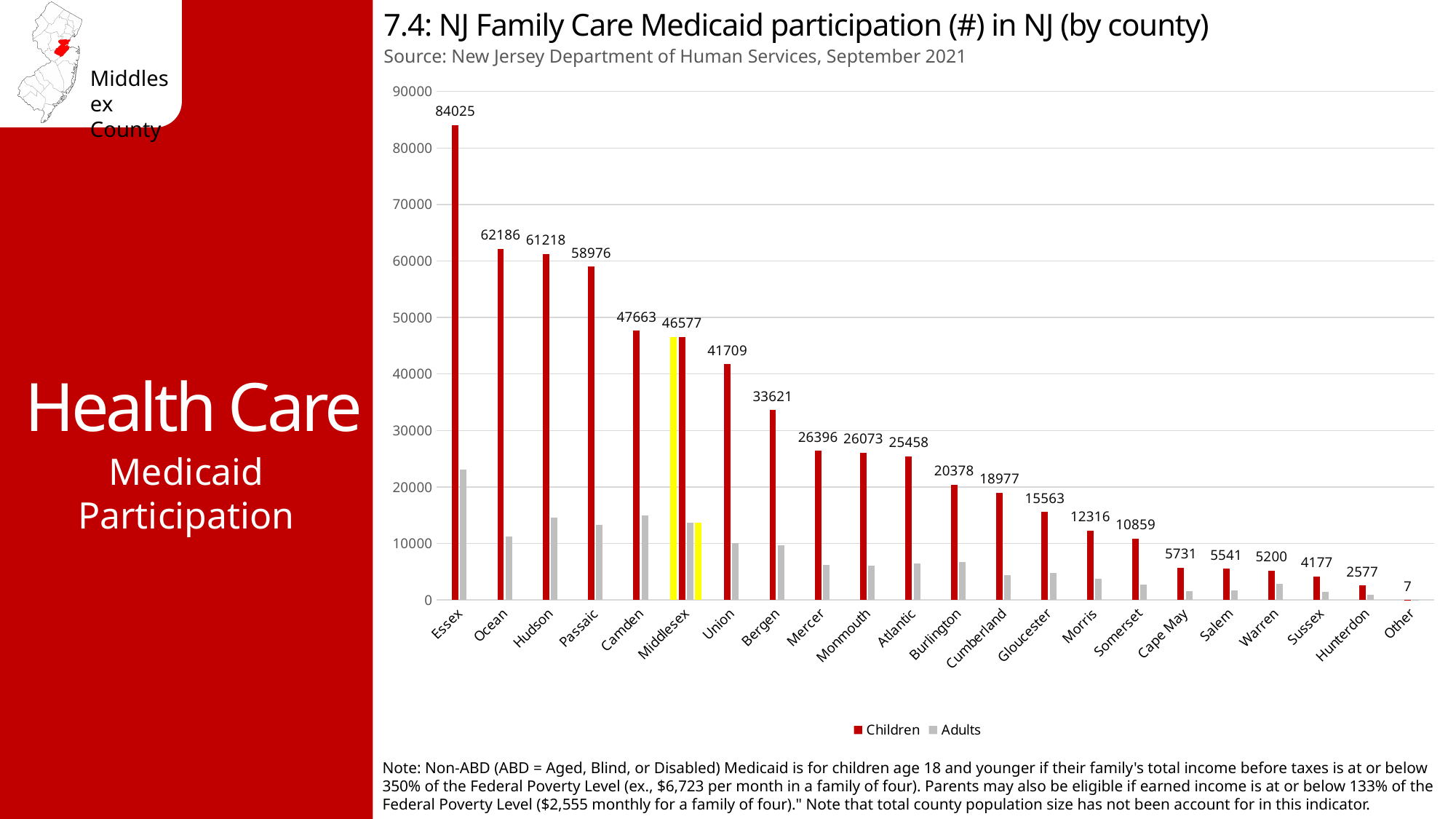
How many series does the legend list? 2 What is the Children value for Cape May? 5731 How many categories are shown on the x axis? 22 What is the Children value for Essex? 84025 Is the Adults value for Essex greater or less than 20000? greater Which category has the lowest Children value? Other What is the Children value for Middlesex? 46577 Which is larger, the Children value for Camden or for Union? Camden Which county has the highest Children value? Essex What is the difference between the Children values for Ocean and Hudson? 968 What kind of chart is shown on the slide? Bar chart